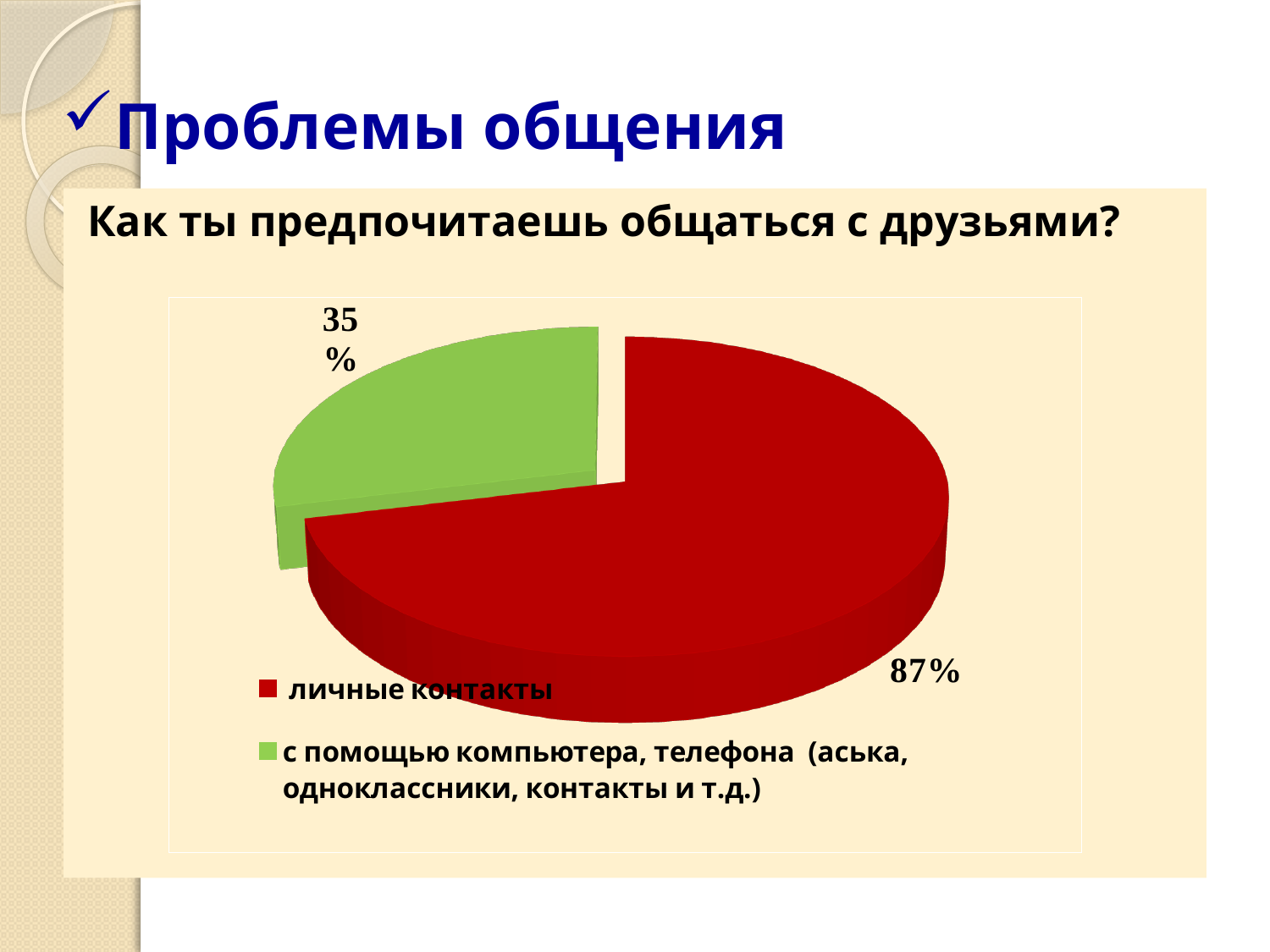
Which is larger: the slice for "личные контакты" or the slice for "с помощью компьютера, телефона"? личные контакты What is the difference in percentage points between the "личные контакты" slice and the "с помощью компьютера, телефона" slice? 52 percentage points What colour is the slice for "личные контакты"? Red How many slices does the pie chart have? 2 Which category has the largest slice of the pie? личные контакты How many entries does the legend list? 2 What question is the chart answering, as written above it? Как ты предпочитаешь общаться с друзьями? What percentage is shown for "с помощью компьютера, телефона (аська, одноклассники, контакты и т.д.)"? 35% Which category has the smallest slice of the pie? с помощью компьютера, телефона (аська, одноклассники, контакты и т.д.) What percentage is shown for "личные контакты"? 87% What kind of chart is shown on the slide? Pie chart